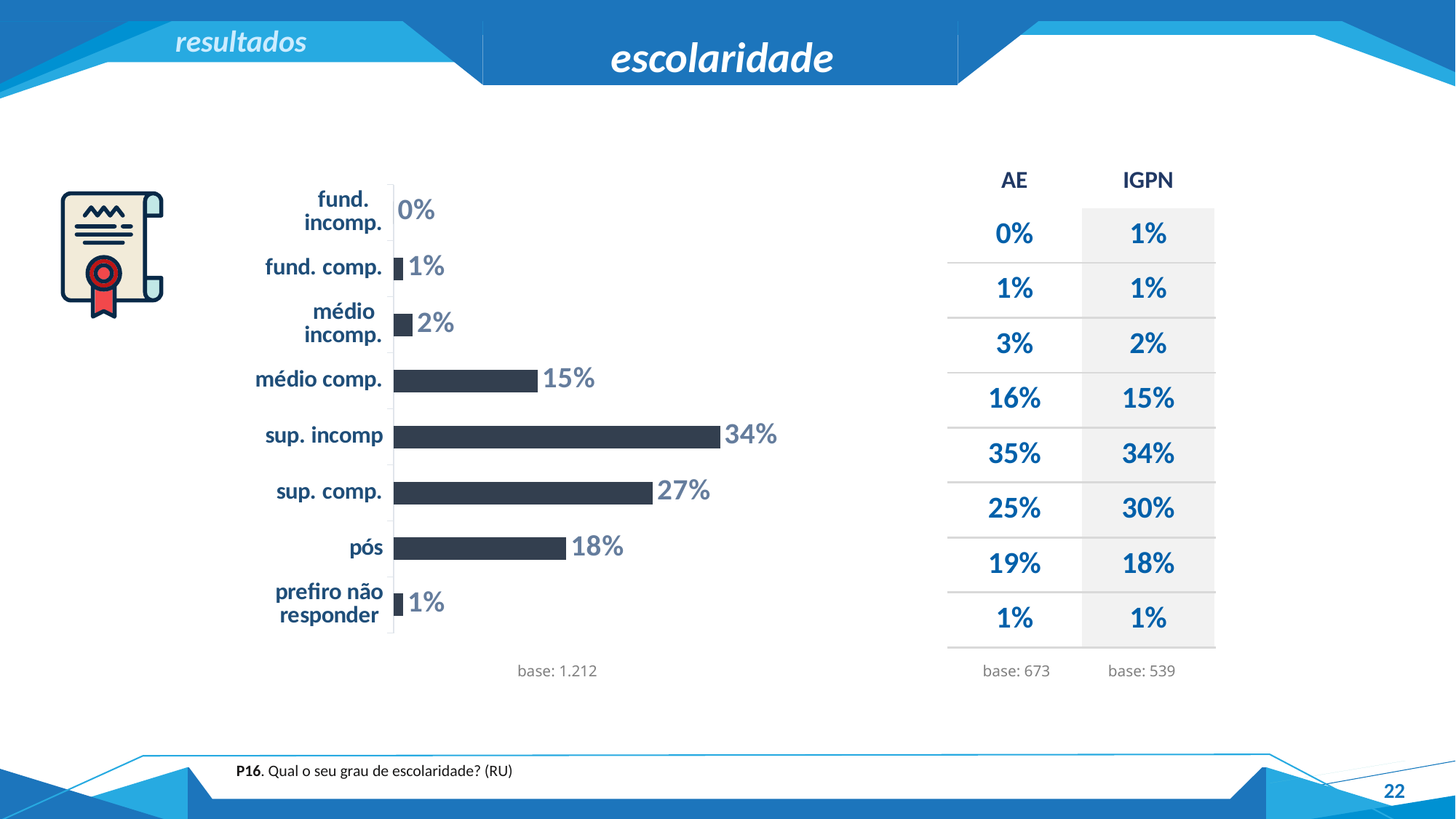
What is the value for "pós" in the bar chart? 18% What is the difference between the values for "médio comp." and "médio incomp." in the bar chart? 13% What base (sample size) is shown below the bar chart? base: 1.212 Which category has the highest value in the bar chart? sup. incomp What is the difference between the values for "sup. incomp" and "sup. comp." in the bar chart? 7% What is the value for "médio comp." in the bar chart? 15% Which is larger in the bar chart, the value for "sup. comp." or the value for "pós"? sup. comp. What is the value for "sup. incomp" in the bar chart? 34% Which category has the lowest value in the bar chart? fund. incomp. How many categories are shown in the bar chart? 8 What kind of chart is shown on the slide? bar chart What is the value for "fund. incomp." in the bar chart? 0%